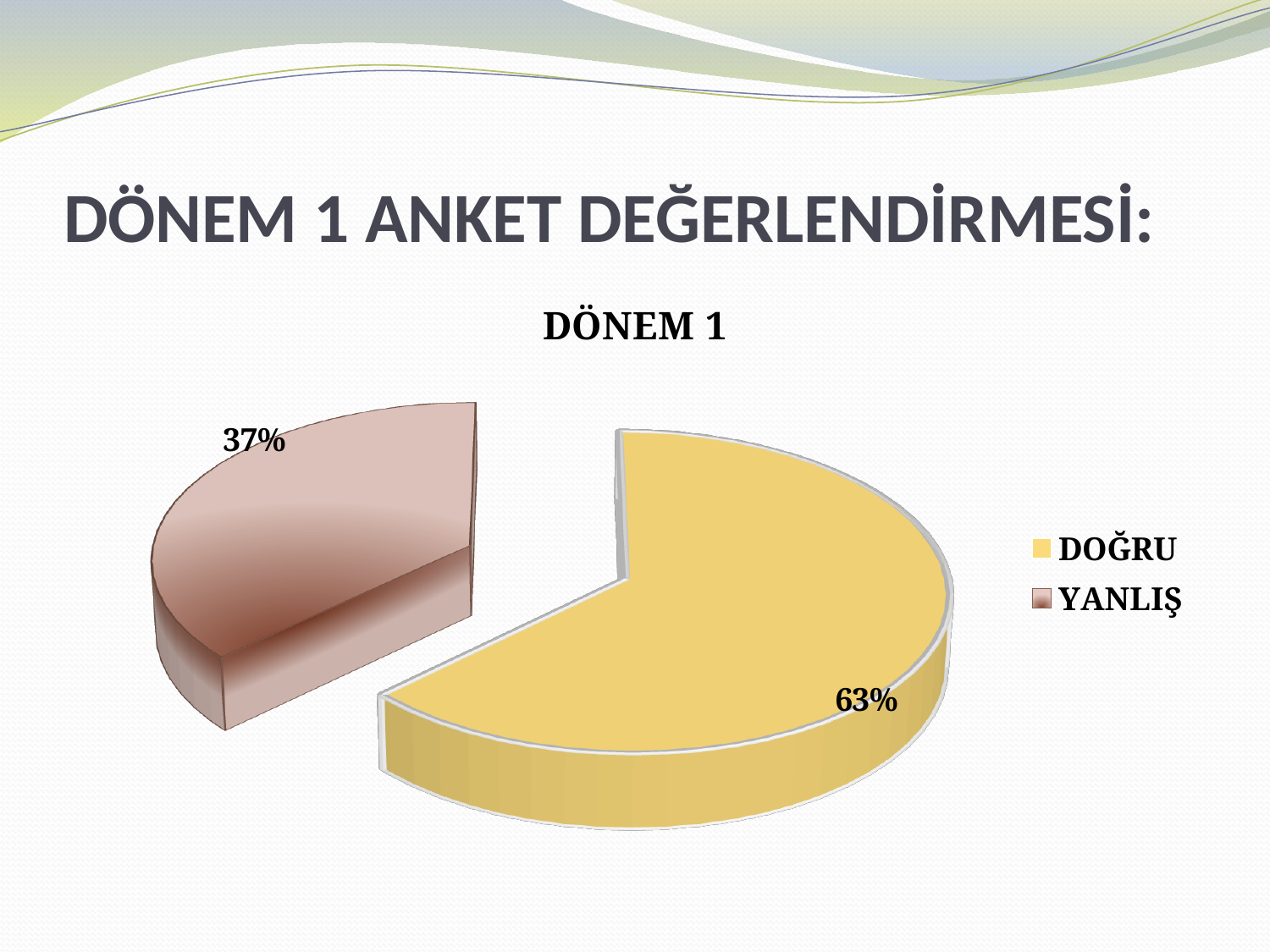
What is the chart's title? DÖNEM 1 What percentage is shown for YANLIŞ? 37% How many slices does the pie chart have? 2 How many entries does the legend list? 2 What kind of chart is shown on the slide? pie chart What percentage is shown for DOĞRU? 63% What is the difference between the DOĞRU and YANLIŞ percentages? 26% Which is larger, DOĞRU or YANLIŞ? DOĞRU What share of the pie does DOĞRU take? 63% What colour is the DOĞRU slice? yellow Which slice is the largest? DOĞRU Which slice is the smallest? YANLIŞ